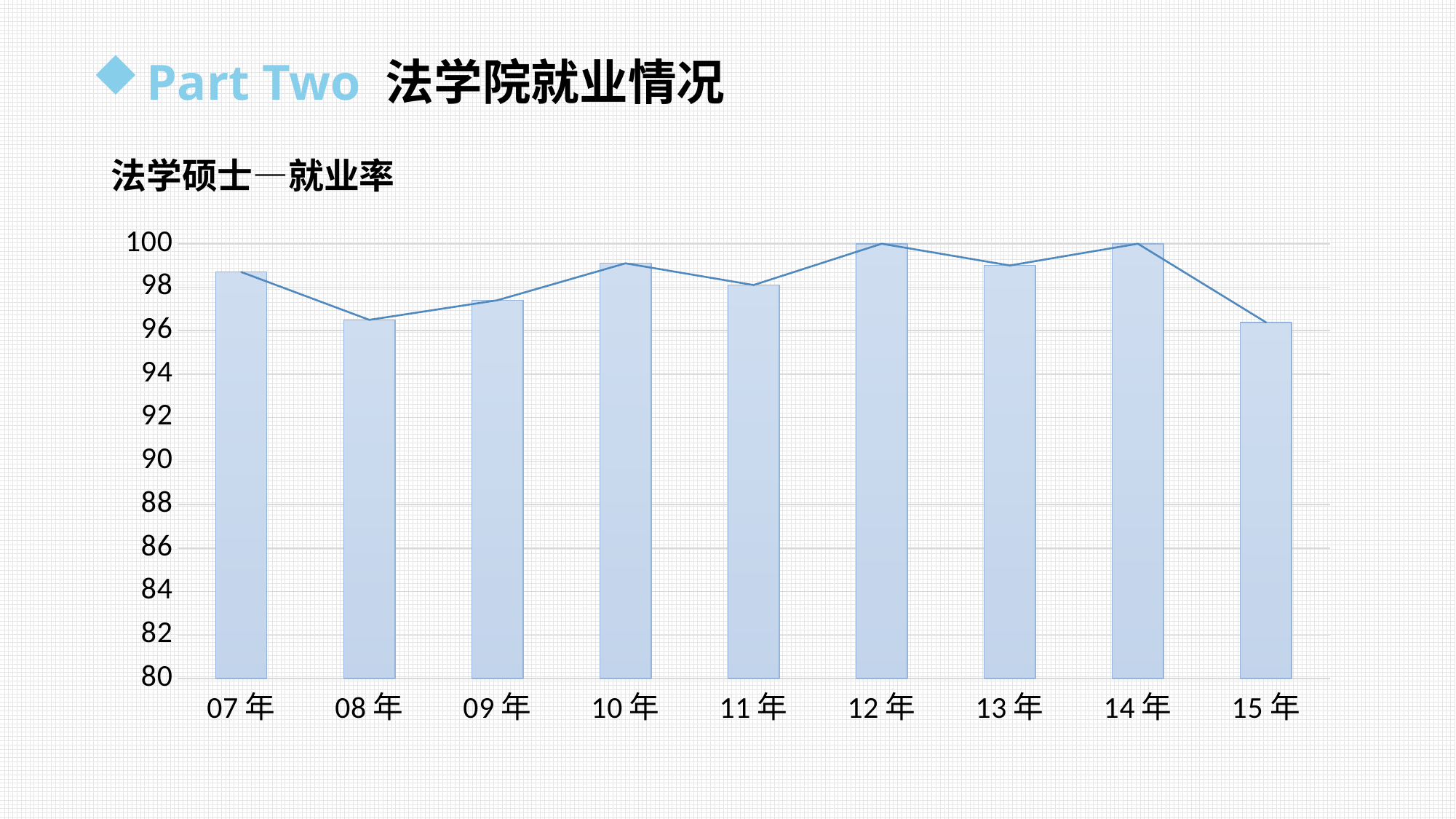
What kind of chart is shown on the slide? combination bar and line chart Which is larger, the value for 07年 or the value for 08年? 07年 How many years are shown on the x axis of the chart? 9 Is the value for 10年 greater or less than 98? greater Is the value for 07年 greater or less than 98? greater What is the value for 14年? 100 Does the value rise or fall from 14年 to 15年? fall What is the title of the chart? 法学硕士—就业率 Which is larger, the value for 10年 or the value for 09年? 10年 Is the value for 15年 greater or less than 98? less What is the value for 12年? 100